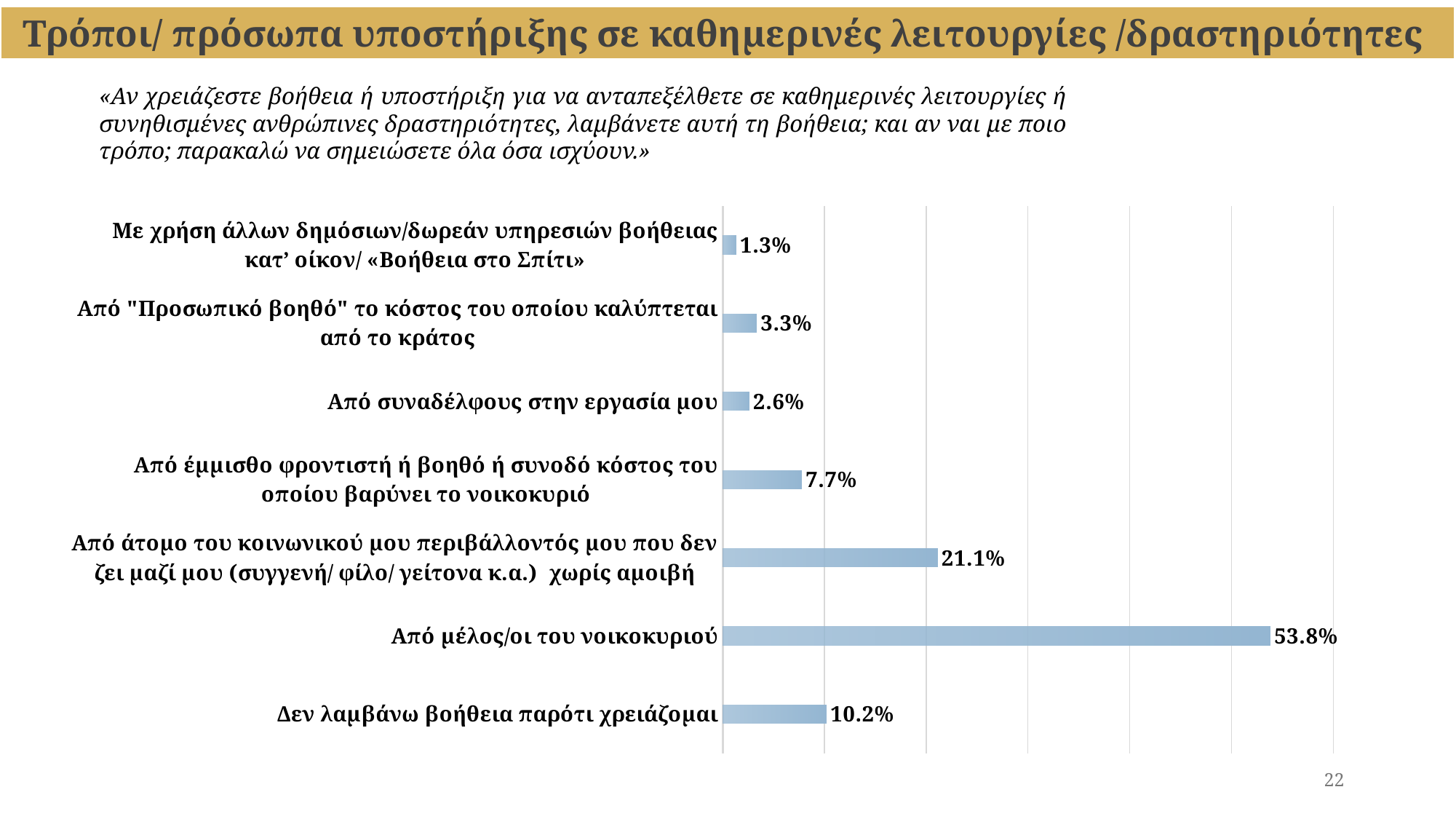
Which category has the highest value? Από μέλος/οι του νοικοκυριού What is the value for «Από έμμισθο φροντιστή ή βοηθό ή συνοδό κόστος του οποίου βαρύνει το νοικοκυριό»? 7.7% Which category has the lowest value? Με χρήση άλλων δημόσιων/δωρεάν υπηρεσιών βοήθειας κατ’ οίκον/ «Βοήθεια στο Σπίτι» What is the difference between the values for «Από μέλος/οι του νοικοκυριού» and «Από άτομο του κοινωνικού μου περιβάλλοντός μου που δεν ζει μαζί μου (συγγενή/ φίλο/ γείτονα κ.α.) χωρίς αμοιβή»? 32.7% What is the value for «Από μέλος/οι του νοικοκυριού»? 53.8% What is the value for «Από συναδέλφους στην εργασία μου»? 2.6% What kind of chart is shown on the slide? bar chart What is the difference between the values for «Δεν λαμβάνω βοήθεια παρότι χρειάζομαι» and «Από έμμισθο φροντιστή ή βοηθό ή συνοδό κόστος του οποίου βαρύνει το νοικοκυριό»? 2.5% What is the title of the slide containing the chart? Τρόποι/ πρόσωπα υποστήριξης σε καθημερινές λειτουργίες /δραστηριότητες Which is larger: the value for «Από "Προσωπικό βοηθό" το κόστος του οποίου καλύπτεται από το κράτος» or the value for «Από συναδέλφους στην εργασία μου»? Από "Προσωπικό βοηθό" το κόστος του οποίου καλύπτεται από το κράτος How many categories does the chart show? 7 What is the value for «Δεν λαμβάνω βοήθεια παρότι χρειάζομαι»? 10.2%